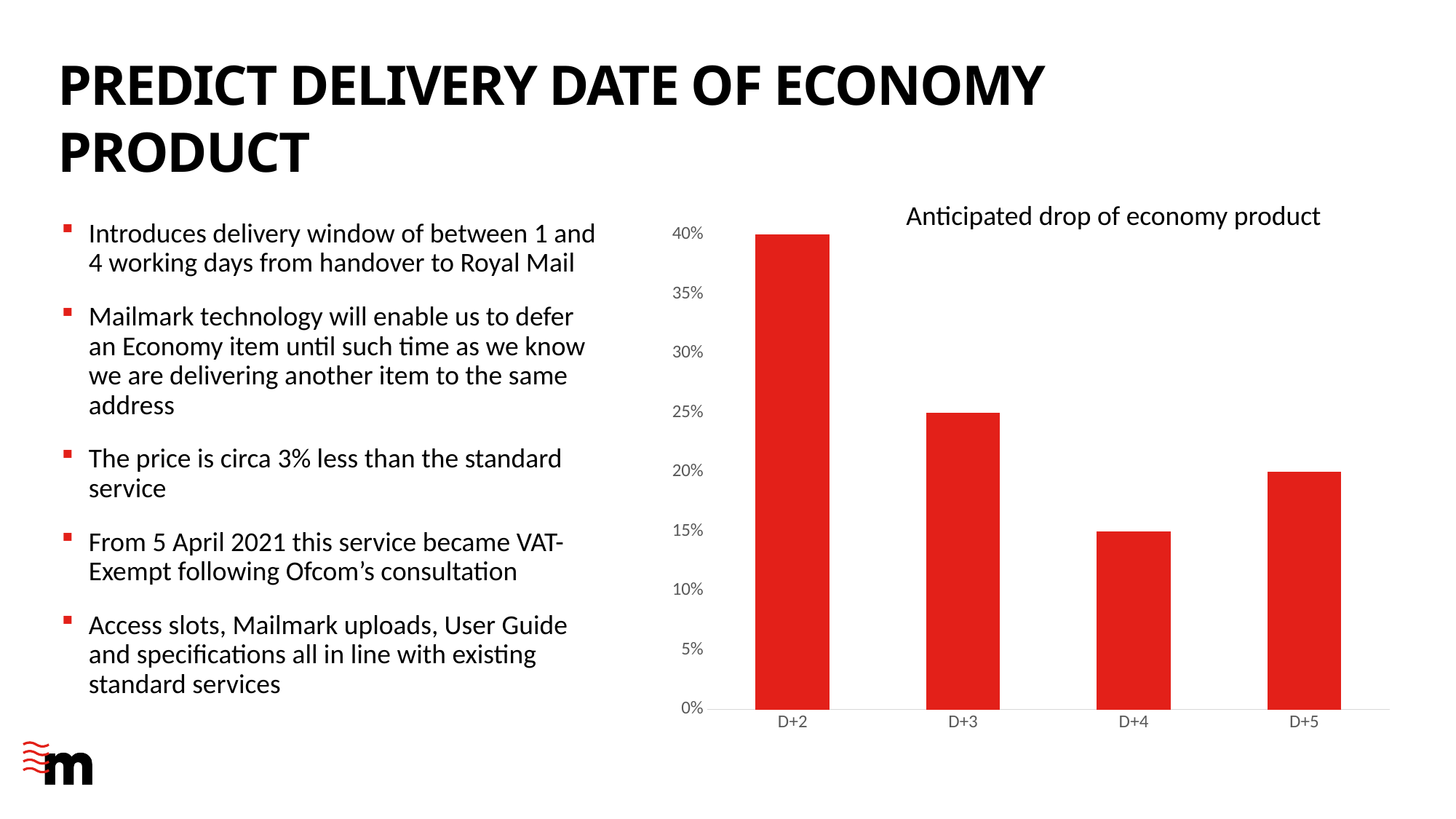
What is the value for D+4 in the chart? 15% What is the difference between the values for D+2 and D+3? 15% Which category has the highest value in the chart? D+2 What is the value for D+3 in the chart? 25% What is the value for D+2 in the Anticipated drop of economy product chart? 40% What is the value for D+5 in the chart? 20% Which category has the lowest value in the chart? D+4 How many categories are shown on the x axis of the chart? 4 What kind of chart is shown on the slide? bar chart Which is larger, the value for D+4 or the value for D+5? D+5 Is the value for D+3 greater or less than 30%? less What is the title of the chart on the slide? Anticipated drop of economy product